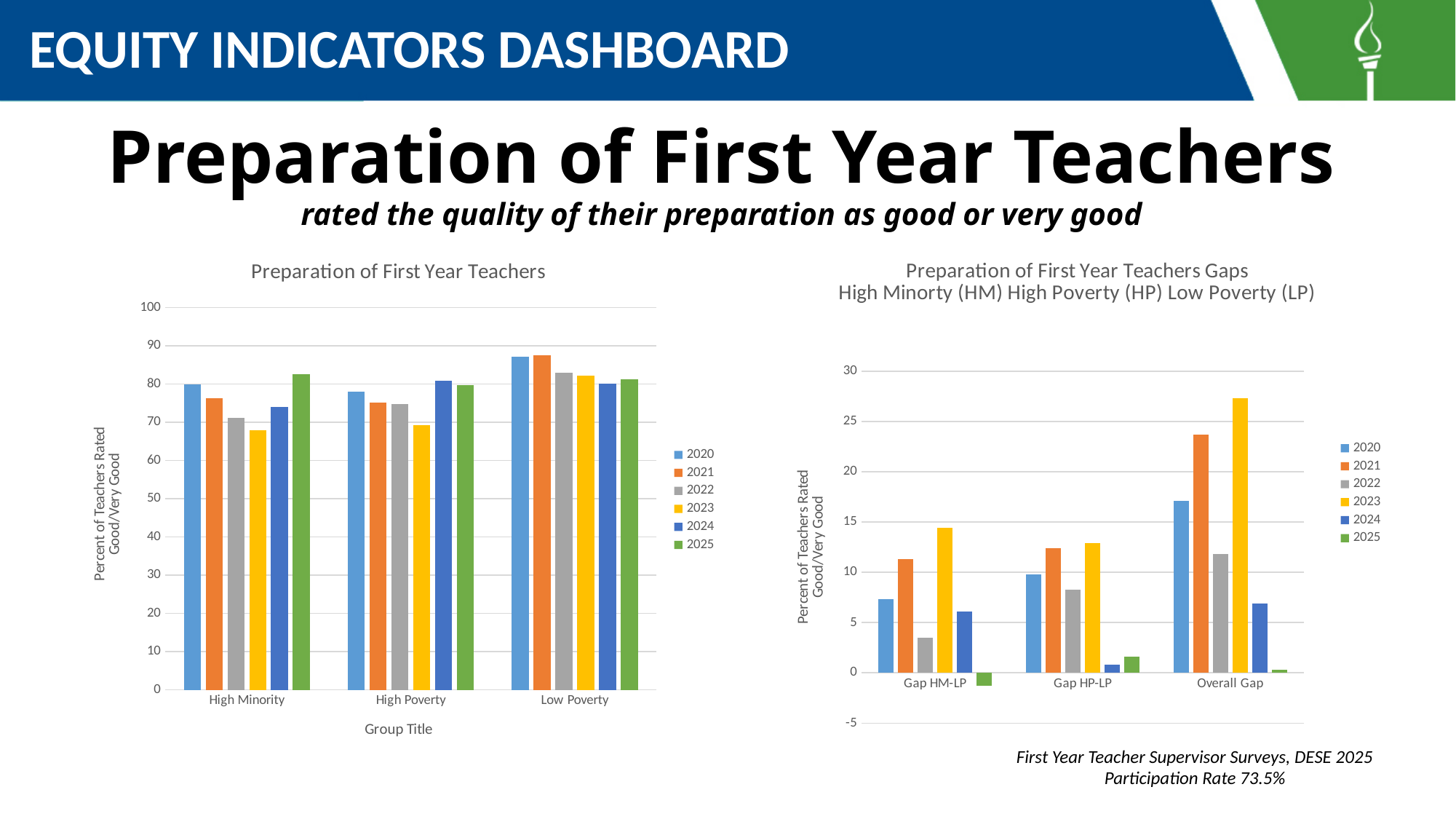
In the left chart "Preparation of First Year Teachers", which year has the highest value for High Minority? 2025 In the left chart "Preparation of First Year Teachers", is the value for Low Poverty in 2021 greater or less than 80? greater In the left chart "Preparation of First Year Teachers", is the value for High Minority in 2023 greater or less than 70? less In the right chart "Preparation of First Year Teachers Gaps", what is the label on the vertical axis? Percent of Teachers Rated Good/Very Good In the right chart "Preparation of First Year Teachers Gaps", is the value for Gap HM-LP in 2025 greater or less than 0? less In the right chart "Preparation of First Year Teachers Gaps", which year has the highest Overall Gap? 2023 In the chart titled "Preparation of First Year Teachers" on the left, what kind of chart is shown? bar chart In the left chart "Preparation of First Year Teachers", how many series does the legend list? 6 In the left chart "Preparation of First Year Teachers", which year has the lowest value for High Minority? 2023 In the left chart "Preparation of First Year Teachers", how many groups are shown on the x axis? 3 In the left chart "Preparation of First Year Teachers", which is larger for 2020: High Minority or Low Poverty? Low Poverty